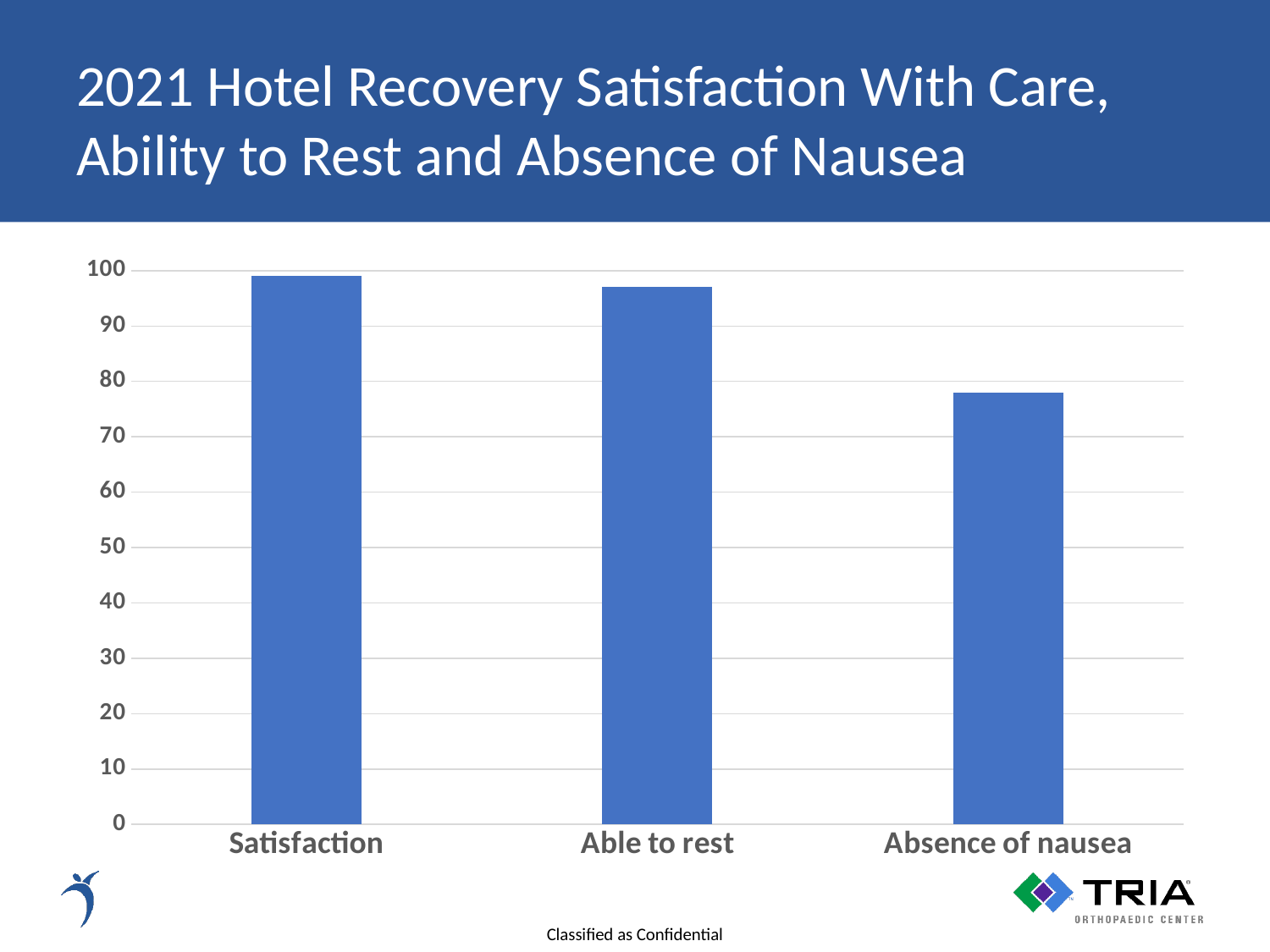
What kind of chart is shown on the slide? bar chart Is the value for Able to rest greater or less than 100? less What is the highest value shown on the vertical axis? 100 Which category has the lowest value? Absence of nausea Which is larger, the value for Able to rest or the value for Absence of nausea? Able to rest How many categories are plotted on the chart? 3 Is the value for Able to rest greater or less than 90? greater What is the title of the slide containing the chart? 2021 Hotel Recovery Satisfaction With Care, Ability to Rest and Absence of Nausea Is the value for Absence of nausea greater or less than 70? greater Which is larger, the value for Satisfaction or the value for Absence of nausea? Satisfaction